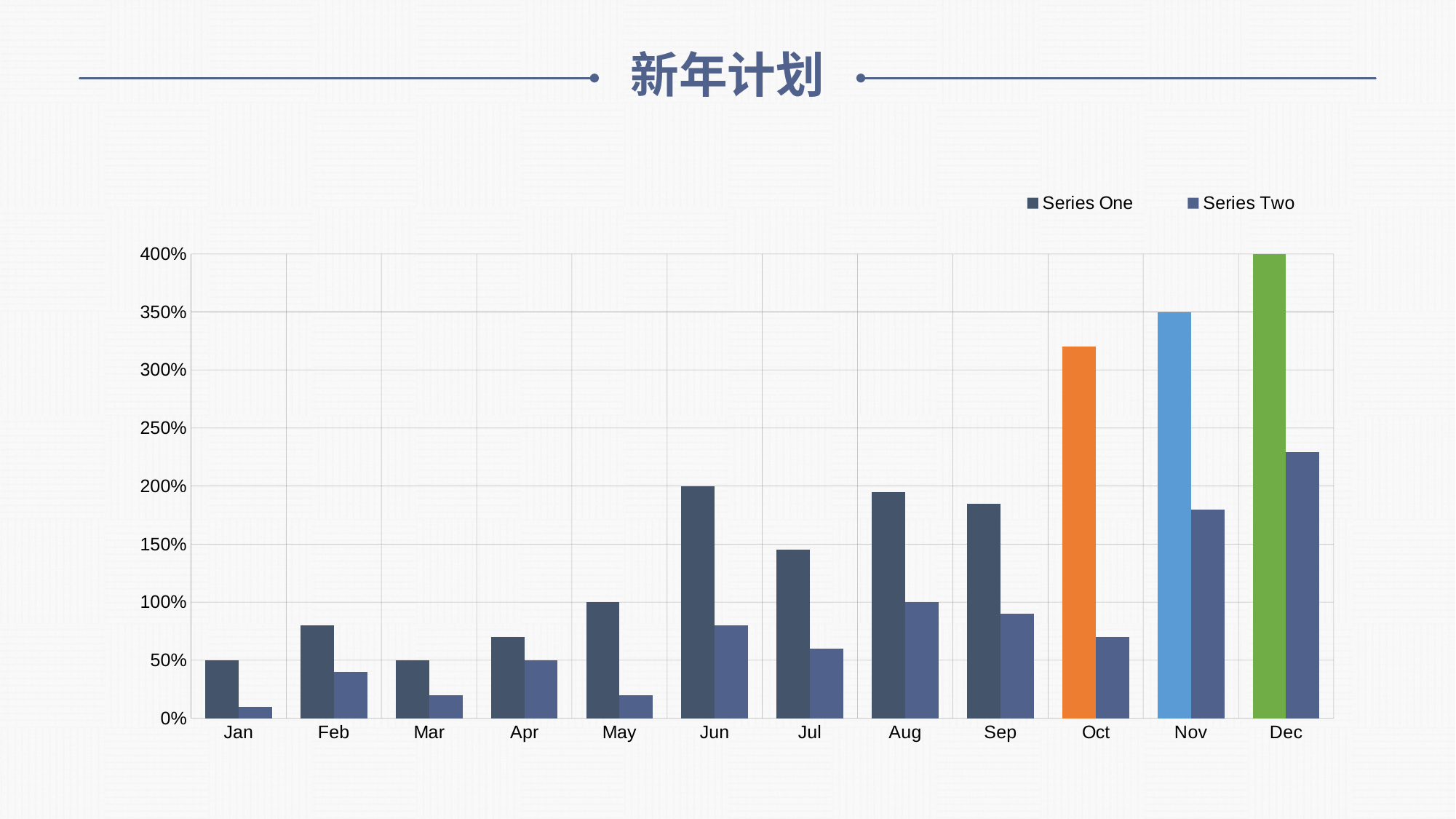
What is the difference between the Series One values for Dec and Nov? 50% What is the Series One value for May? 100% What type of chart is shown on the slide? bar chart What is the Series One value for Dec? 400% Which month has the lowest Series Two value? Jan How many series does the legend list? 2 Which is larger, the Series One value for Jun or for Jul? Jun Which month has the highest Series One value? Dec What is the Series One value for Nov? 350% How many months are shown on the x axis? 12 What is the Series One value for Jun? 200% Is the Series One value for Oct greater or less than 300%? greater